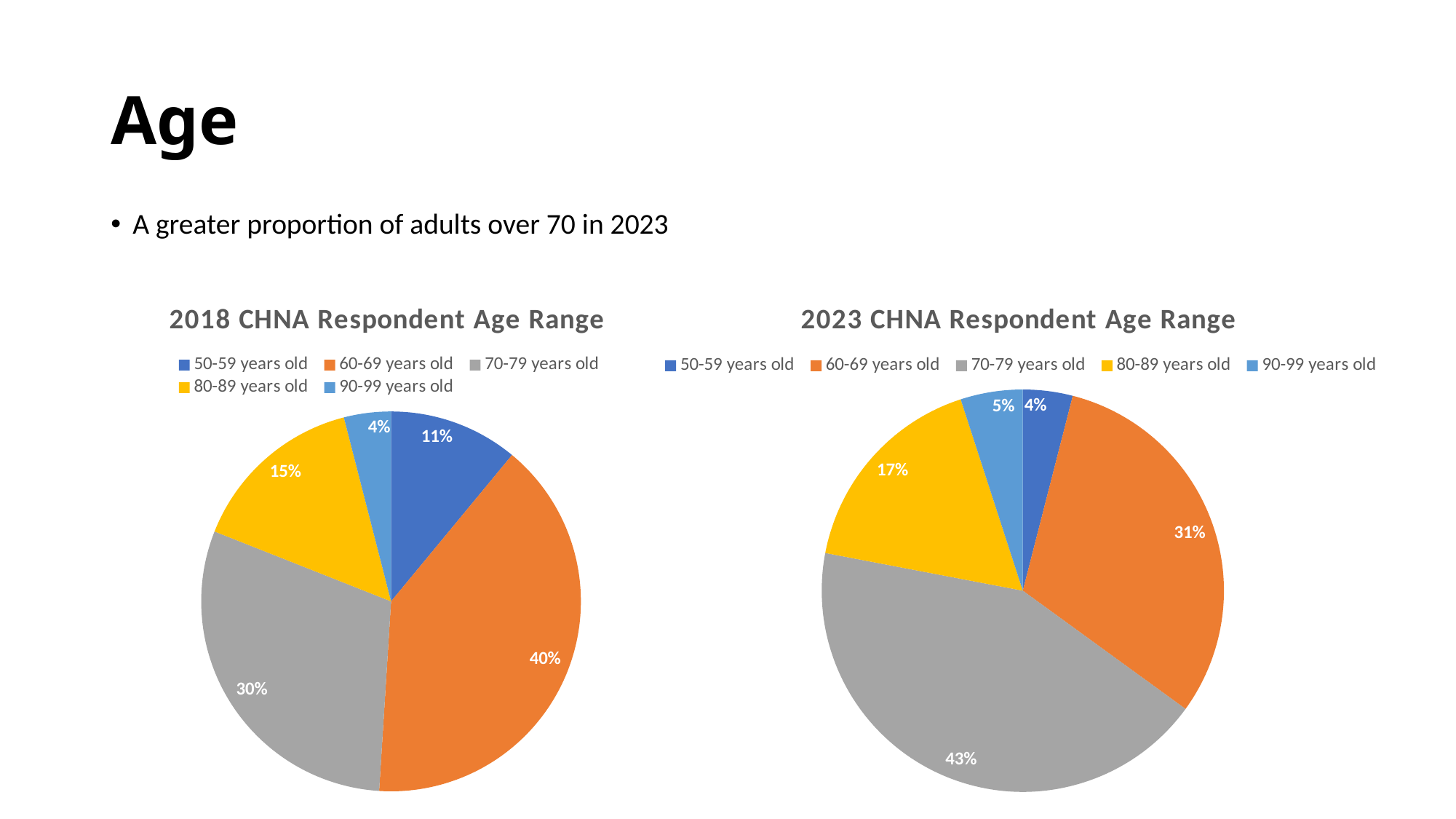
In the 2018 CHNA Respondent Age Range chart, what percentage of respondents were 80-89 years old? 15% In the 2018 CHNA Respondent Age Range chart, which is larger: the 50-59 years old share or the 80-89 years old share? 80-89 years old In the 2018 CHNA Respondent Age Range chart, which age group has the largest share? 60-69 years old In the 2023 CHNA Respondent Age Range chart, what percentage of respondents were 90-99 years old? 5% In the 2018 CHNA Respondent Age Range chart, what is the combined share of respondents aged 70 and over? 49% In the 2023 CHNA Respondent Age Range chart, which age group has the smallest share? 50-59 years old What kind of chart is the 2018 CHNA Respondent Age Range chart? Pie chart In the 2023 CHNA Respondent Age Range chart, what percentage of respondents were 70-79 years old? 43% In the 2023 CHNA Respondent Age Range chart, what is the difference between the 70-79 years old share and the 60-69 years old share? 12% How many age groups does the 2023 CHNA Respondent Age Range chart show? 5 In the 2018 CHNA Respondent Age Range chart, what percentage of respondents were 60-69 years old? 40% In the 2023 CHNA Respondent Age Range chart, which colour represents the 70-79 years old group? Grey